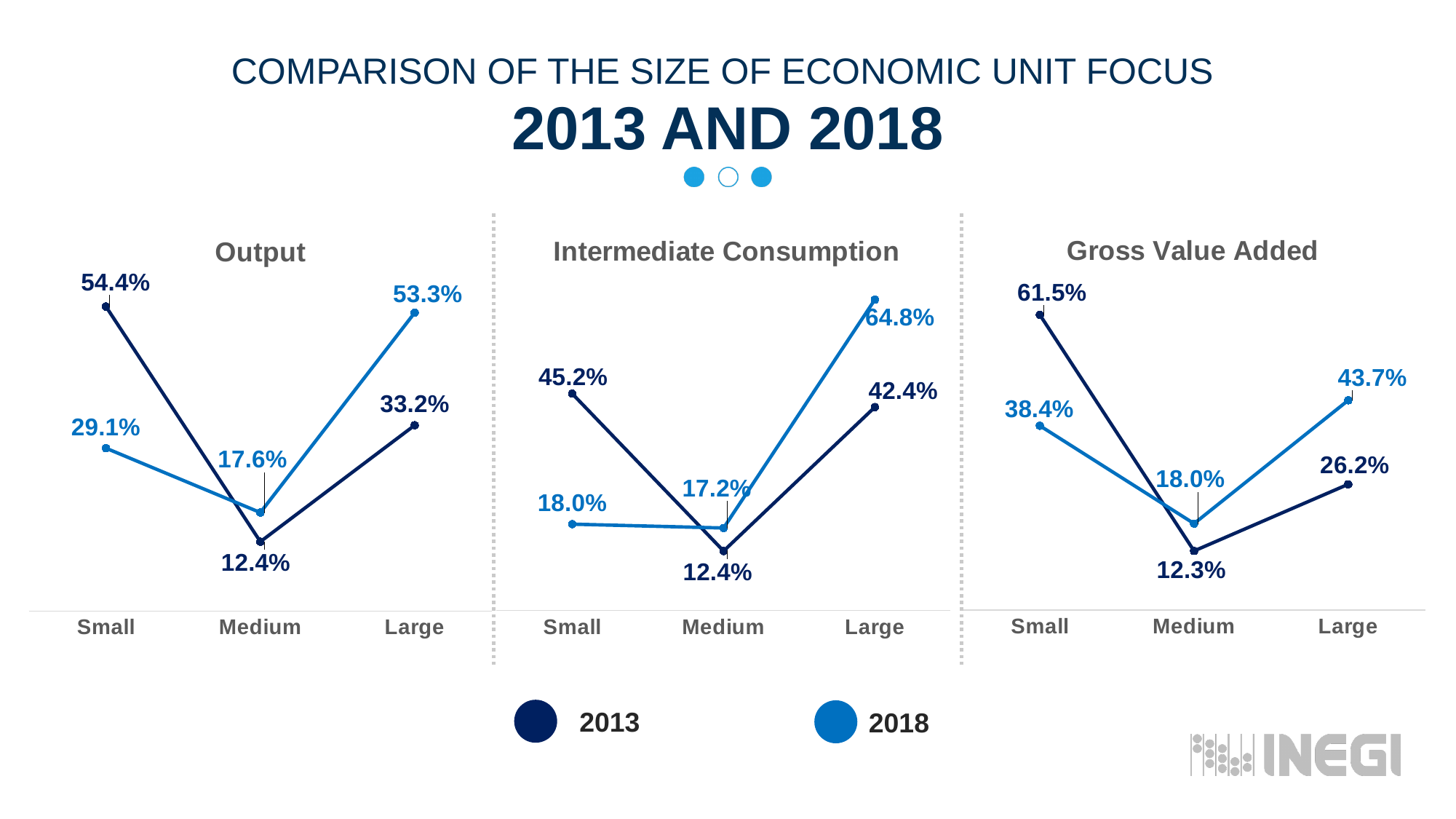
How many categories are shown on the x axis of the Intermediate Consumption chart? 3 In the Gross Value Added chart, which is larger for Large: the 2013 value or the 2018 value? 2018 How many series does the legend list? 2 In the Intermediate Consumption chart, what is the 2018 value for Large? 64.8% What kind of chart is the Output chart? Line chart In the Intermediate Consumption chart, which category has the lowest 2018 value? Medium In the Output chart, what is the 2018 value for Large? 53.3% In the Gross Value Added chart, what is the 2013 value for Medium? 12.3% In the Gross Value Added chart, which category has the highest 2013 value? Small In the Intermediate Consumption chart, does the 2018 series rise or fall from Medium to Large? Rise In the Output chart, what is the difference between the 2013 and 2018 values for Small? 25.3% In the Output chart, what is the 2013 value for Small? 54.4%